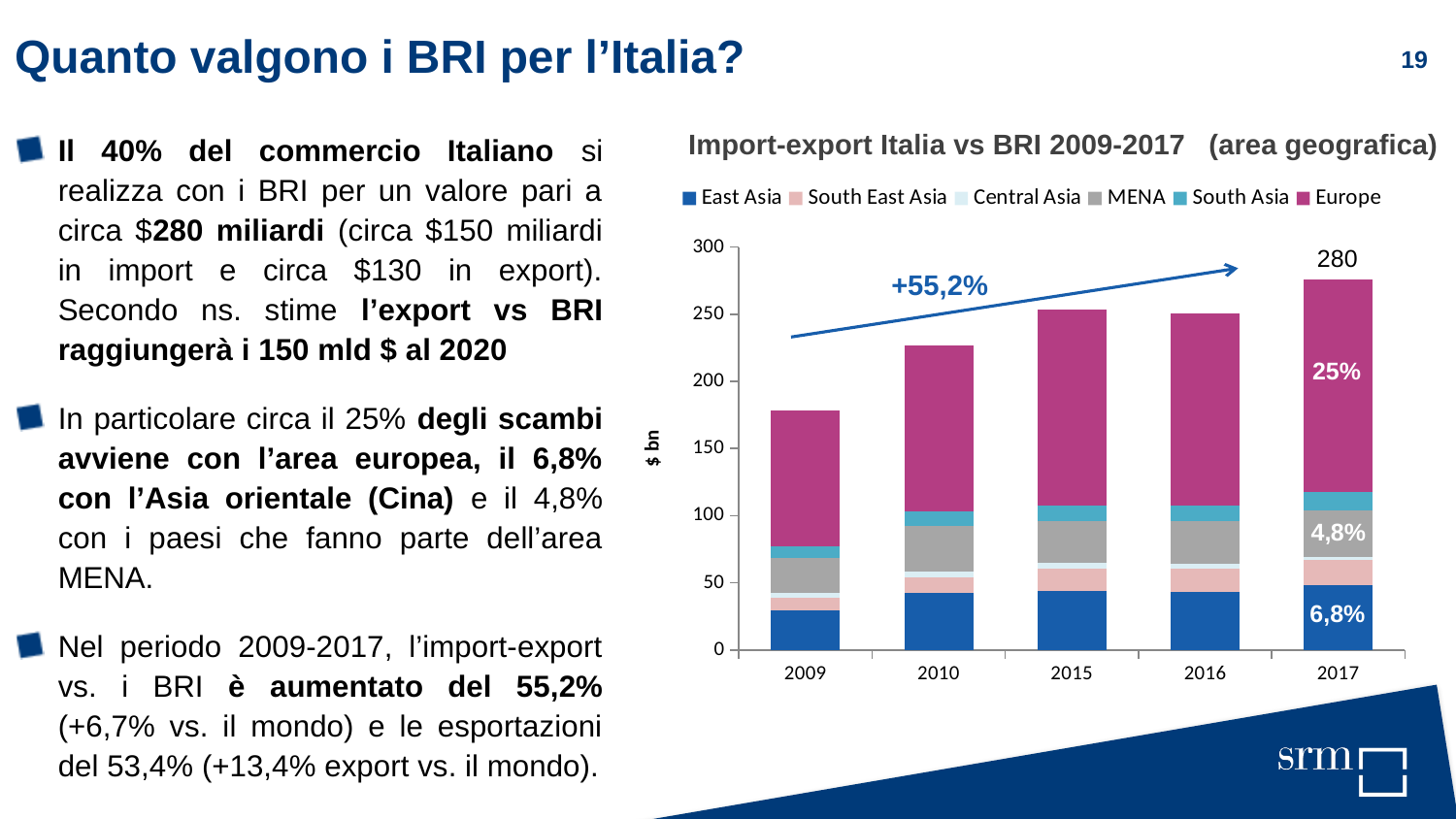
What percentage increase is written on the arrow annotation above the bars? +55,2% What is the total value labelled on the 2017 bar? 280 What percentage is labelled on the Europe segment of the 2017 bar? 25% How many years (categories) are shown on the x axis of the chart? 5 Which year has the lowest total bar? 2009 Is the total value for 2009 greater or less than 200? less Which year has the highest total bar? 2017 What percentage is labelled on the East Asia segment of the 2017 bar? 6,8% What percentage is labelled on the MENA segment of the 2017 bar? 4,8% Which year has the larger total bar, 2010 or 2015? 2015 How many series does the chart legend list? 6 What type of chart is shown on the slide? Stacked bar chart